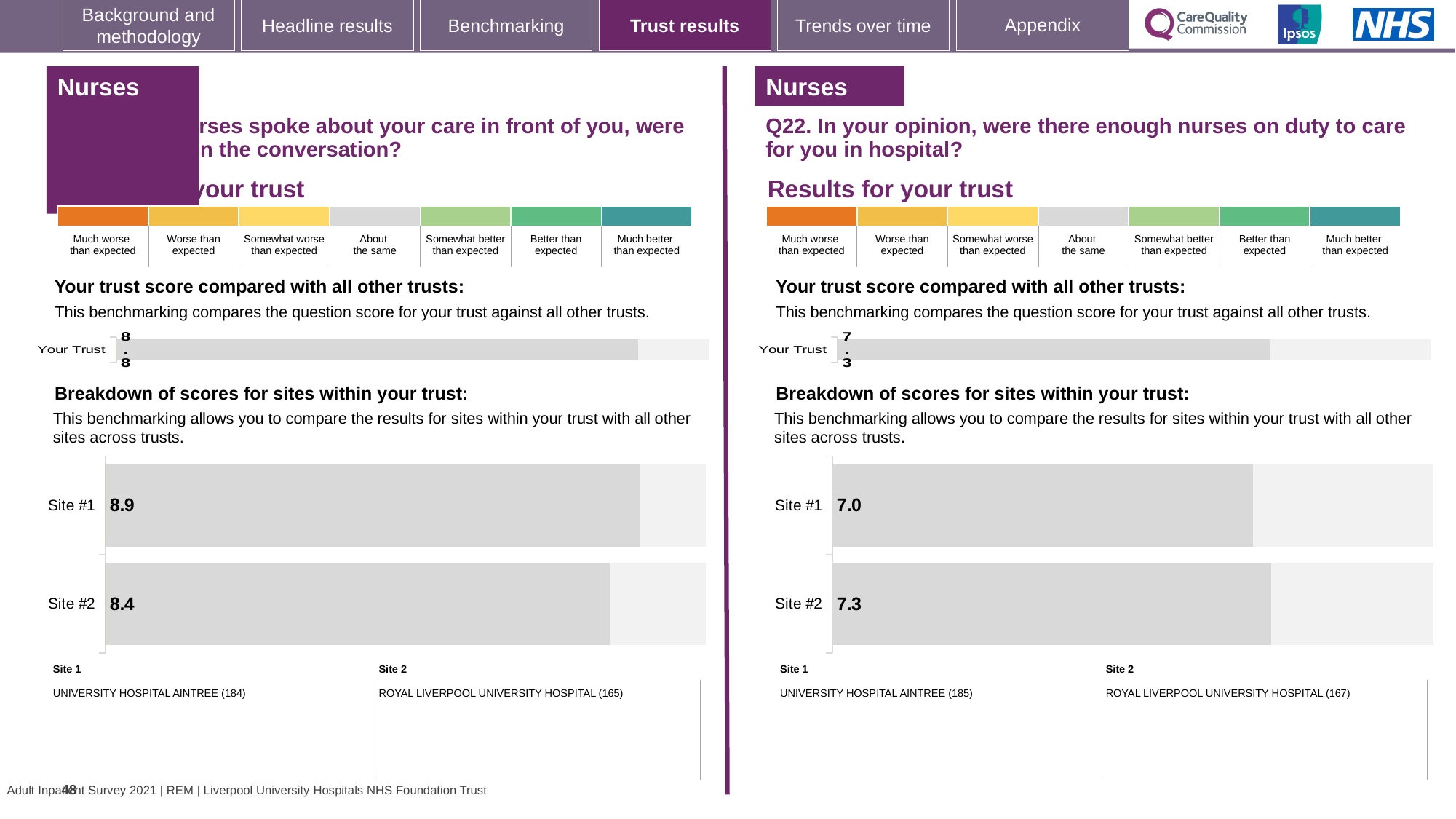
In the 'Your Trust' chart for Q22 (enough nurses on duty), what is the trust score? 7.3 In the site breakdown chart for Q22 (enough nurses on duty), which site has the lower score? Site #1 How many sites are shown in the site breakdown chart for Q22 (enough nurses on duty)? 2 In the site breakdown chart on the left half of the slide, which site has the higher score? Site #1 In the site breakdown chart for Q22 (enough nurses on duty), what is the score for Site #2? 7.3 What type of chart is used for the site breakdown on the left half of the slide? Bar chart In the site breakdown chart for Q22 (enough nurses on duty), what is the difference between the Site #2 and Site #1 scores? 0.3 In the site breakdown chart for Q22 (enough nurses on duty), what is the score for Site #1? 7.0 In the site breakdown chart on the left half of the slide, what is the score for Site #1? 8.9 In the site breakdown chart on the left half of the slide, what is the score for Site #2? 8.4 In the 'Your Trust' chart on the left half of the slide, what is the trust score? 8.8 In the site breakdown chart on the left half of the slide, what is the difference between the Site #1 and Site #2 scores? 0.5